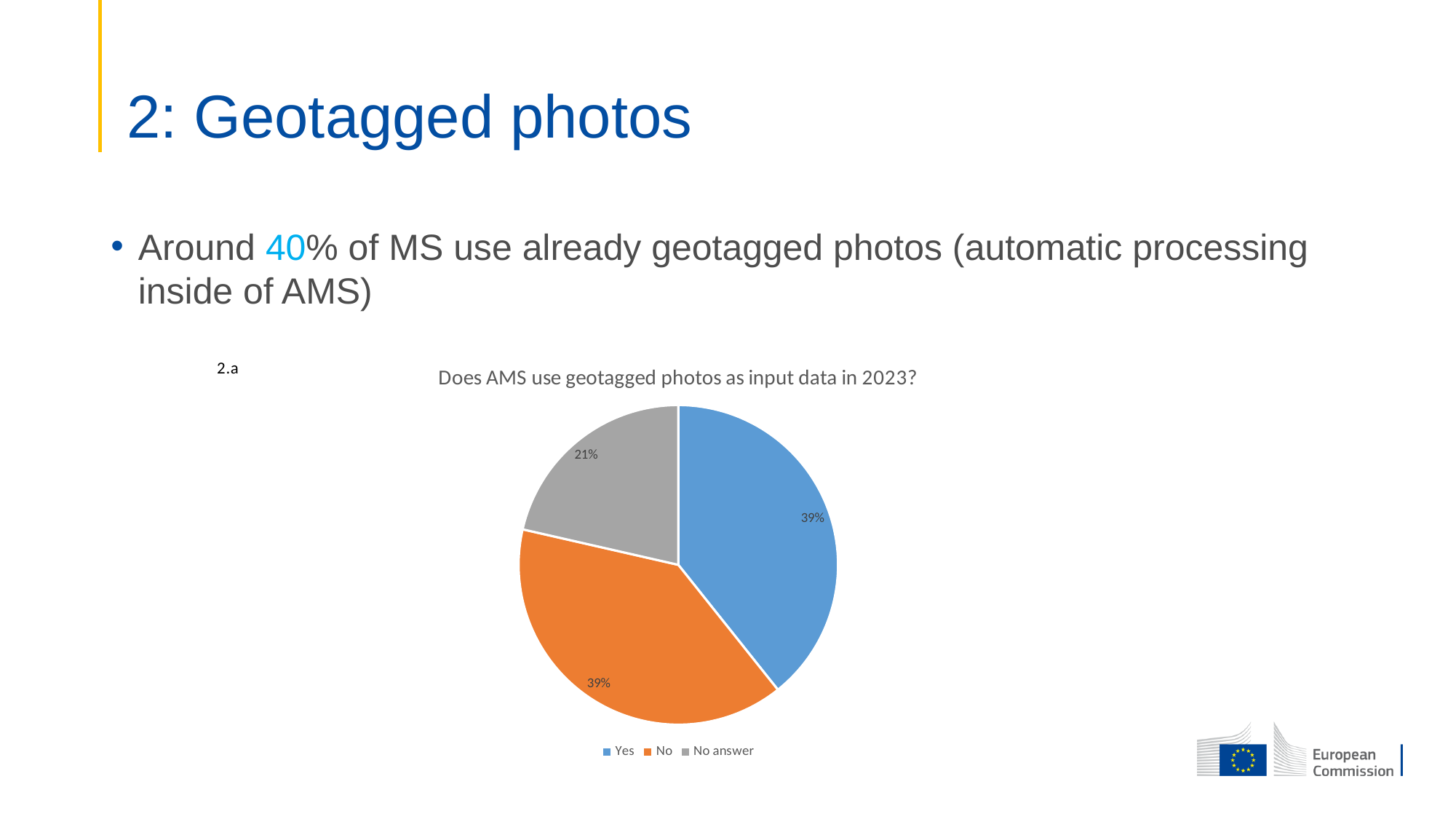
What share of the pie is labelled "No"? 39% How many entries does the legend list? 3 Which colour represents the "No" category in the pie chart? orange Which category has the smallest slice of the pie? No answer What share of the pie is labelled "No answer"? 21% Is the "Yes" slice larger or smaller than the "No answer" slice? larger What kind of chart is shown on the slide? pie chart What is the difference in percentage points between the "Yes" slice and the "No answer" slice? 18 What share of the pie is labelled "Yes"? 39% How many slices does the pie chart have? 3 What is the title of the pie chart? Does AMS use geotagged photos as input data in 2023?